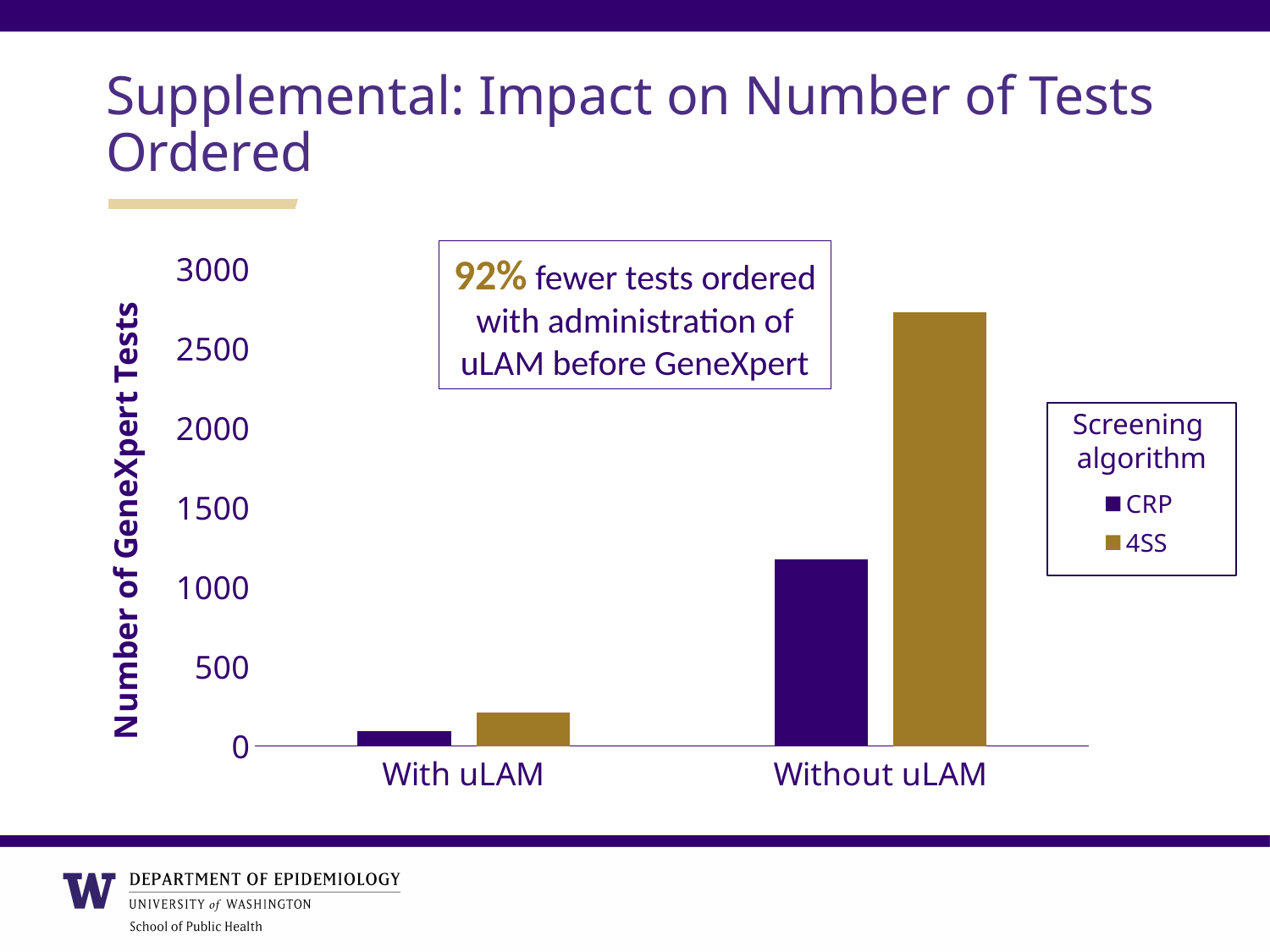
Which category and series has the shortest bar in the chart? With uLAM, CRP Is the value for CRP in the Without uLAM category greater or less than 1000? greater Which category and series has the tallest bar in the chart? Without uLAM, 4SS Is the value for 4SS in the With uLAM category greater or less than 500? less How many series does the chart's legend list? 2 Is the value for 4SS in the Without uLAM category greater or less than 2500? greater How many categories are shown on the x axis of the chart? 2 What kind of chart is shown on the slide? bar chart For the CRP series, which category has the larger value, With uLAM or Without uLAM? Without uLAM In the Without uLAM category, which series has the larger value, CRP or 4SS? 4SS What is the title of the chart's legend? Screening algorithm What is the label on the chart's vertical axis? Number of GeneXpert Tests